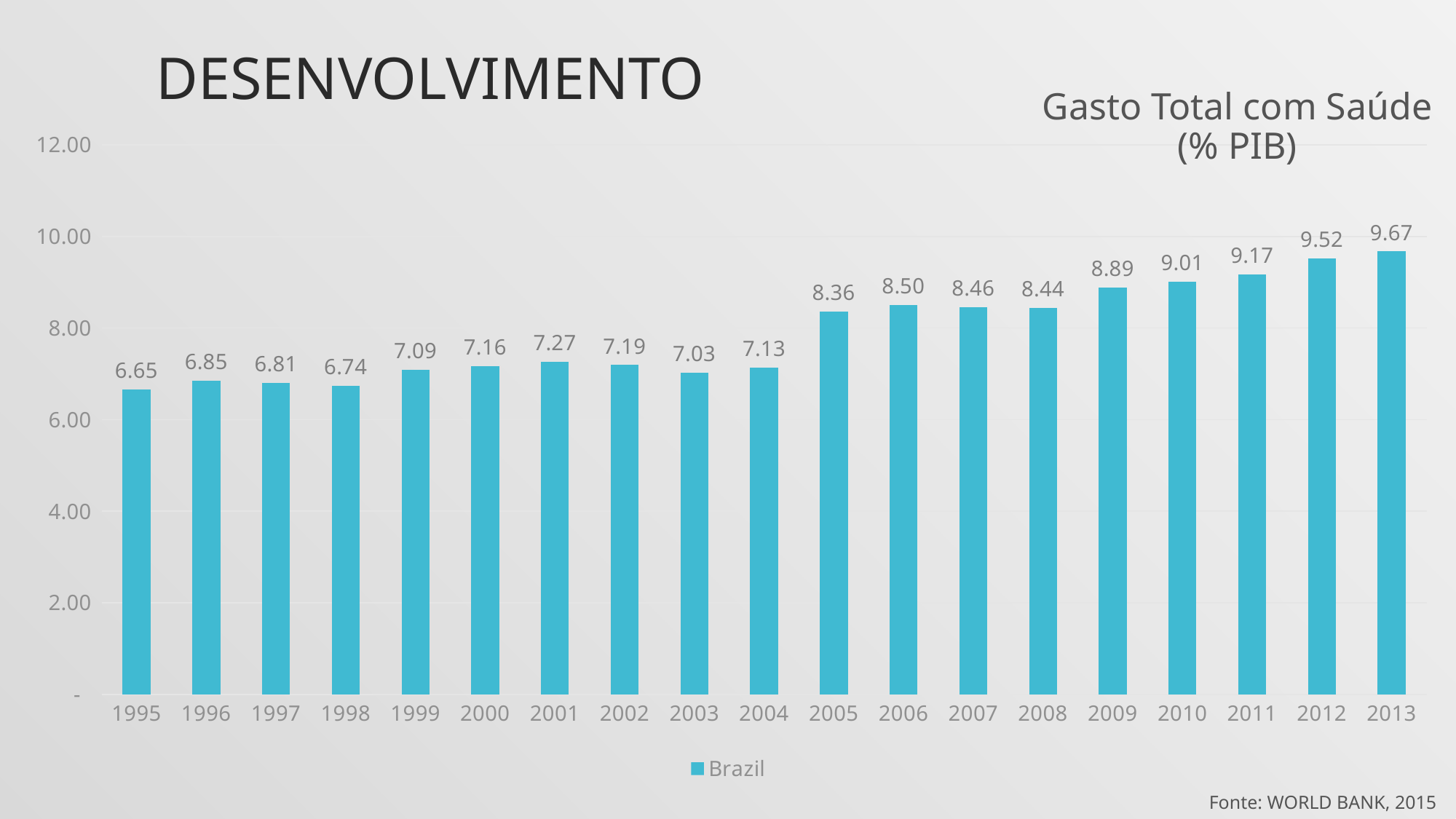
Which is larger, the value for 2001 or the value for 2003? 2001 What is the difference between the values for 2013 and 1995? 3.02 Which year has the lowest value? 1995 What is the value for 2006? 8.50 How many years are shown on the x axis? 19 What is the title of the chart? Gasto Total com Saúde (% PIB) Is the value for 2005 greater or less than 8.00? greater How many series does the legend list? 1 What is the value for 2013? 9.67 Which year has the highest value? 2013 What kind of chart is shown? bar chart What is the value for 1995? 6.65